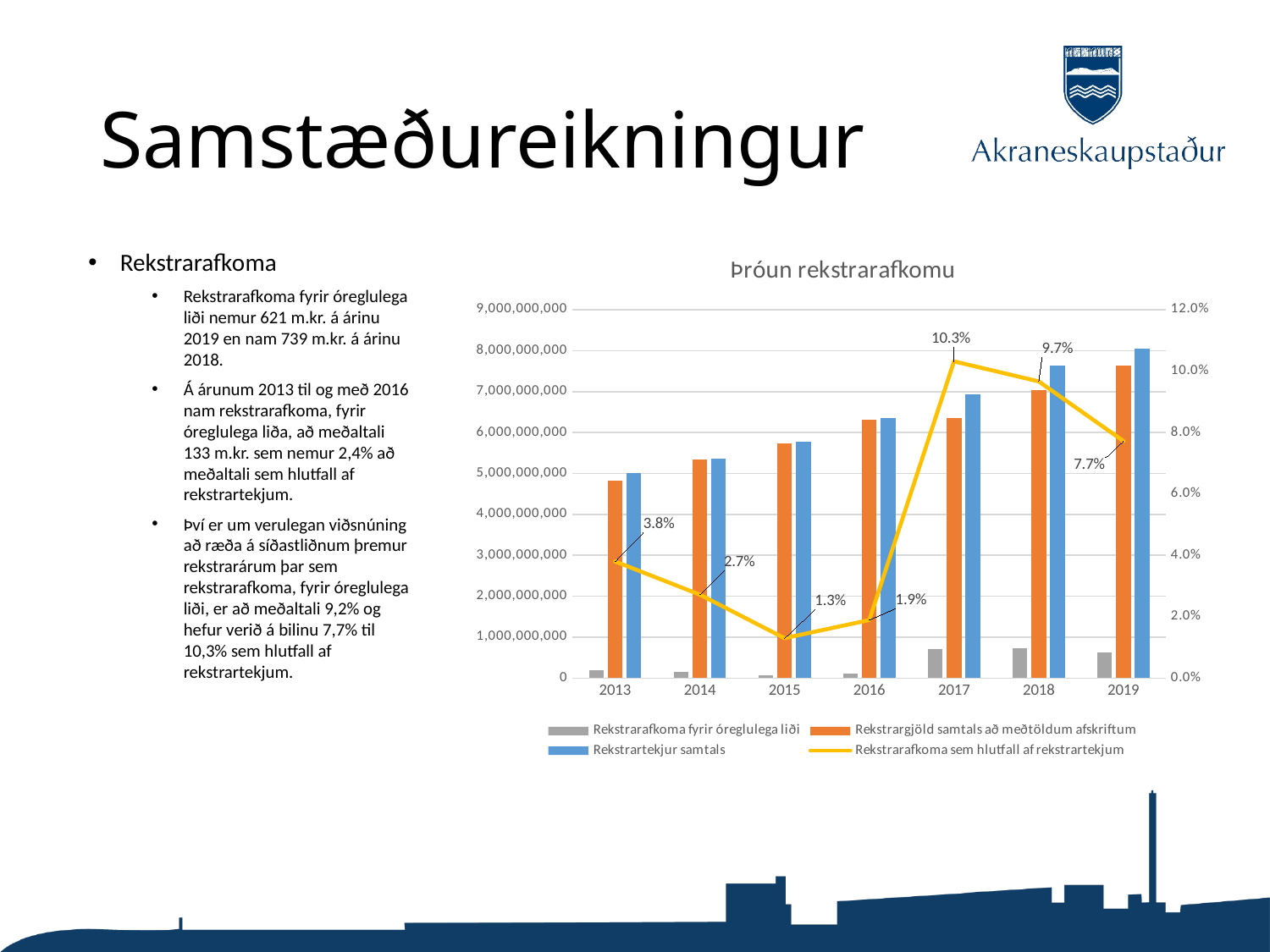
How many series does the legend list? 4 What is the difference between the Rekstrarafkoma sem hlutfall af rekstrartekjum values for 2017 and 2019? 2.6 percentage points Is the value of Rekstrargjöld samtals að meðtöldum afskriftum for 2013 greater or less than 4,000,000,000? greater What is the value of Rekstrarafkoma sem hlutfall af rekstrartekjum for 2019? 7.7% What is the value of Rekstrarafkoma sem hlutfall af rekstrartekjum for 2017? 10.3% How many years are shown on the x axis? 7 What kind of chart is shown? Combination bar and line chart What is the value of Rekstrarafkoma sem hlutfall af rekstrartekjum for 2015? 1.3% Does Rekstrarafkoma sem hlutfall af rekstrartekjum rise or fall from 2013 to 2015? Fall In which year is Rekstrarafkoma sem hlutfall af rekstrartekjum highest? 2017 In which year is Rekstrarafkoma sem hlutfall af rekstrartekjum lowest? 2015 Which year has a higher Rekstrarafkoma sem hlutfall af rekstrartekjum, 2013 or 2016? 2013